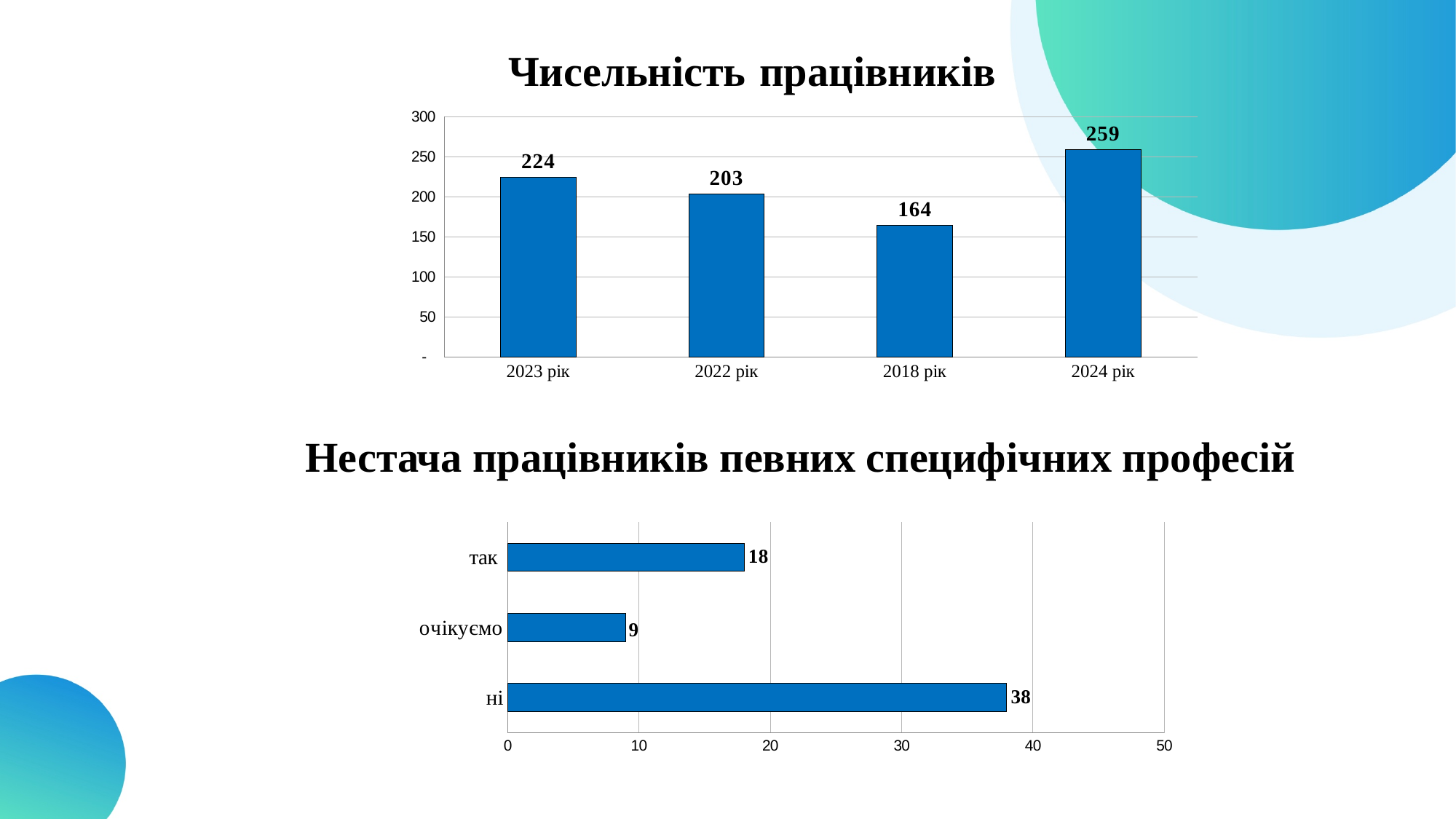
In the chart titled "Чисельність працівників", what is the difference between the values for 2024 рік and 2022 рік? 56 In the chart titled "Нестача працівників певних специфічних професій", what is the difference between the values for ні and так? 20 In the chart titled "Нестача працівників певних специфічних професій", how many categories are shown? 3 In the chart titled "Нестача працівників певних специфічних професій", what is the value for очікуємо? 9 In the chart titled "Чисельність працівників", how many categories are shown on the x axis? 4 In the chart titled "Чисельність працівників", which category has the highest value? 2024 рік In the chart titled "Чисельність працівників", what kind of chart is it? bar chart In the chart titled "Чисельність працівників", what is the value for 2018 рік? 164 In the chart titled "Чисельність працівників", what is the value for 2023 рік? 224 In the chart titled "Нестача працівників певних специфічних професій", which is larger, the value for так or the value for очікуємо? так In the chart titled "Нестача працівників певних специфічних професій", which category has the highest value? ні In the chart titled "Чисельність працівників", which category has the lowest value? 2018 рік